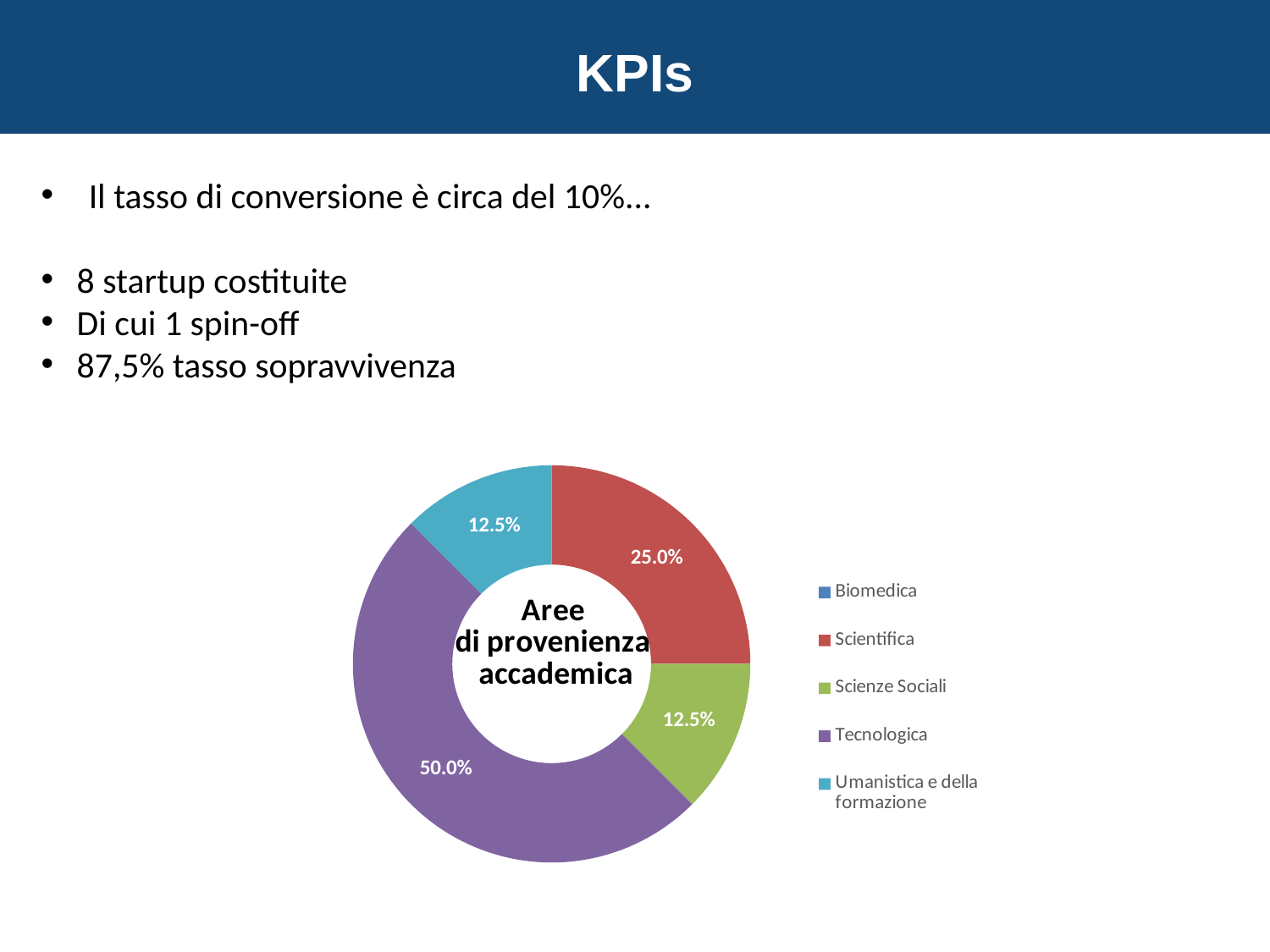
Which category has the largest share of the chart? Tecnologica What is the title shown in the centre of the chart? Aree di provenienza accademica What colour is the Tecnologica slice? purple What share of the chart does Scientifica represent? 25.0% What is the combined share of Scienze Sociali and Umanistica e della formazione? 25.0% What share of the chart does Tecnologica represent? 50.0% How many entries does the legend list? 5 What share of the chart does Scienze Sociali represent? 12.5% Which is larger, the share for Scientifica or the share for Scienze Sociali? Scientifica What share of the chart does Umanistica e della formazione represent? 12.5% What kind of chart is shown on the slide? doughnut chart What is the difference between the share for Tecnologica and the share for Scientifica? 25.0%